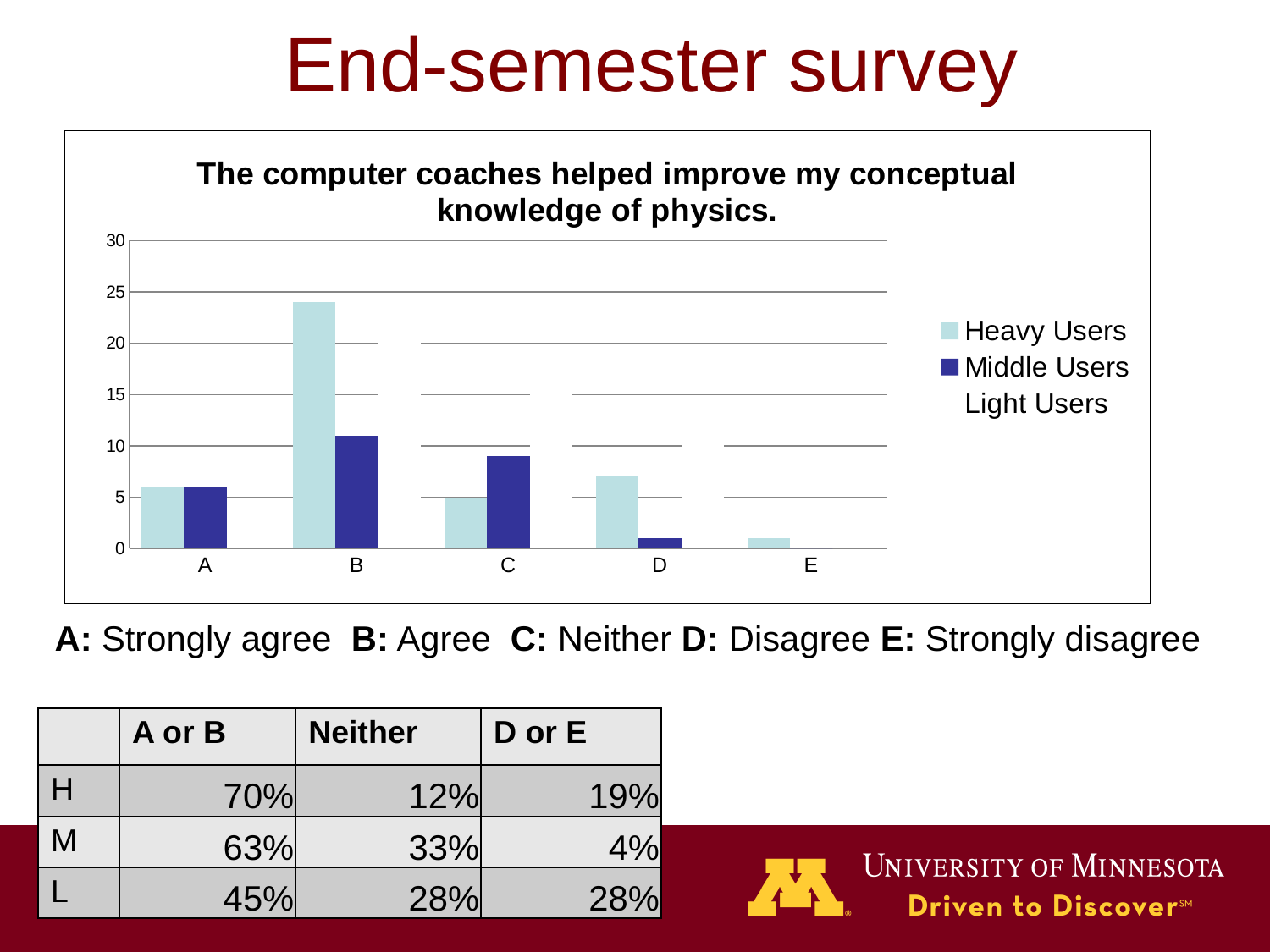
Which category has the highest Middle Users bar? B For category C, which is larger: the Heavy Users bar or the Middle Users bar? Middle Users What is the title of the chart? The computer coaches helped improve my conceptual knowledge of physics. Which category has the lowest Heavy Users bar? E How many series does the chart legend list? 3 How many categories are shown on the x axis of the chart? 5 Is the Heavy Users value for B greater or less than 20? greater Is the Middle Users value for C greater or less than 5? greater For category D, which is larger: the Heavy Users bar or the Middle Users bar? Heavy Users Is the Middle Users value for B greater or less than 15? less Which category has the highest Heavy Users bar? B What kind of chart is shown on the slide? bar chart